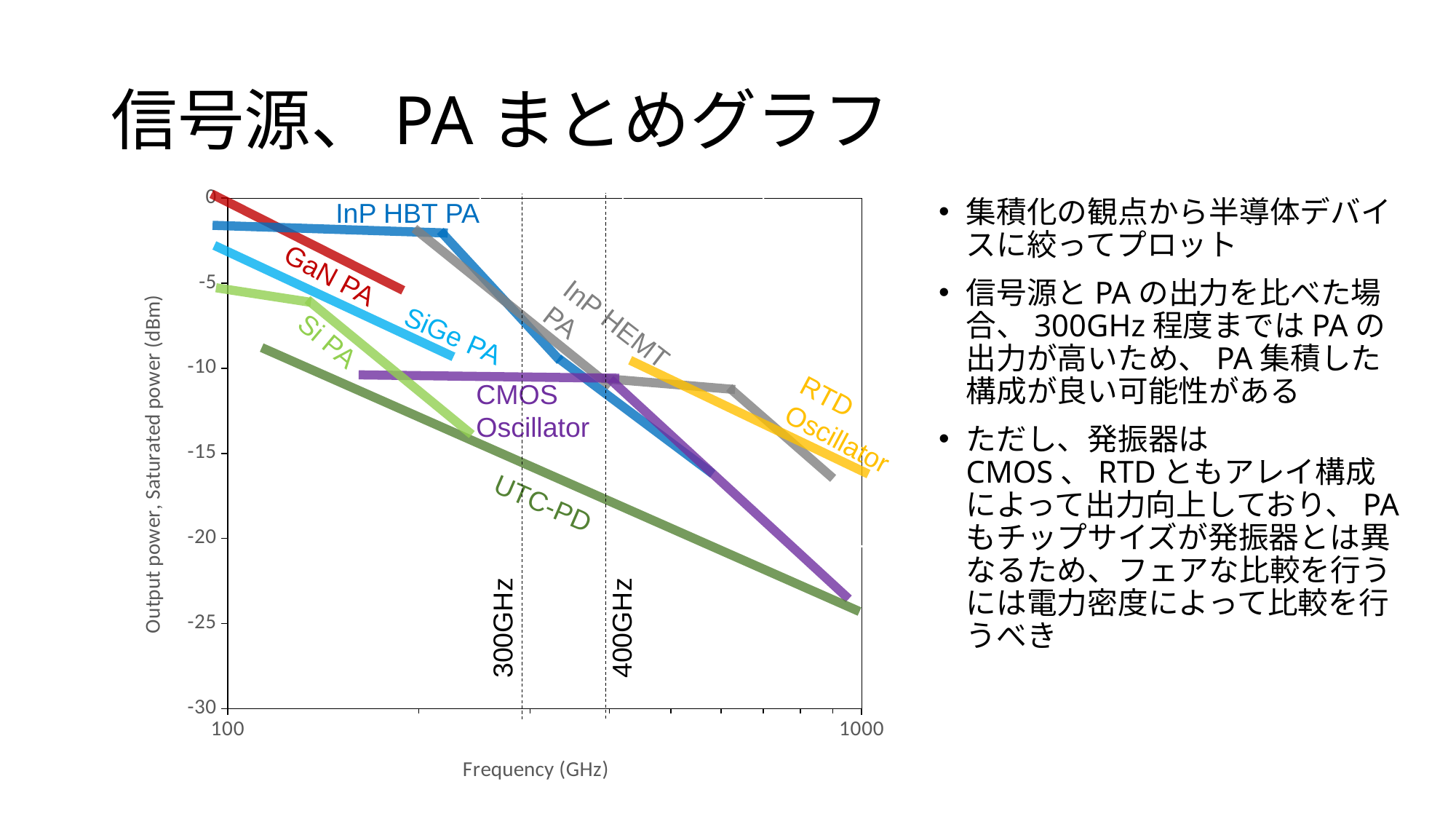
Is the value for InP HBT PA at 100 GHz greater or less than -5 dBm? greater At 1000 GHz, which has the higher output power: RTD Oscillator or UTC-PD? RTD Oscillator Is the value for InP HEMT PA at its highest plotted frequency greater or less than -15 dBm? less What is the label of the y axis of the chart? Output power, Saturated power (dBm) Which series reaches the highest output power on the chart? GaN PA Does the output power of UTC-PD rise or fall as frequency increases? Fall At 100 GHz, which has the higher output power: GaN PA or Si PA? GaN PA Is the value for RTD Oscillator at 1000 GHz greater or less than -20 dBm? greater What is the label of the x axis of the chart? Frequency (GHz) How many labeled series (lines) are plotted on the chart? 8 What kind of chart is shown on the slide? Line chart